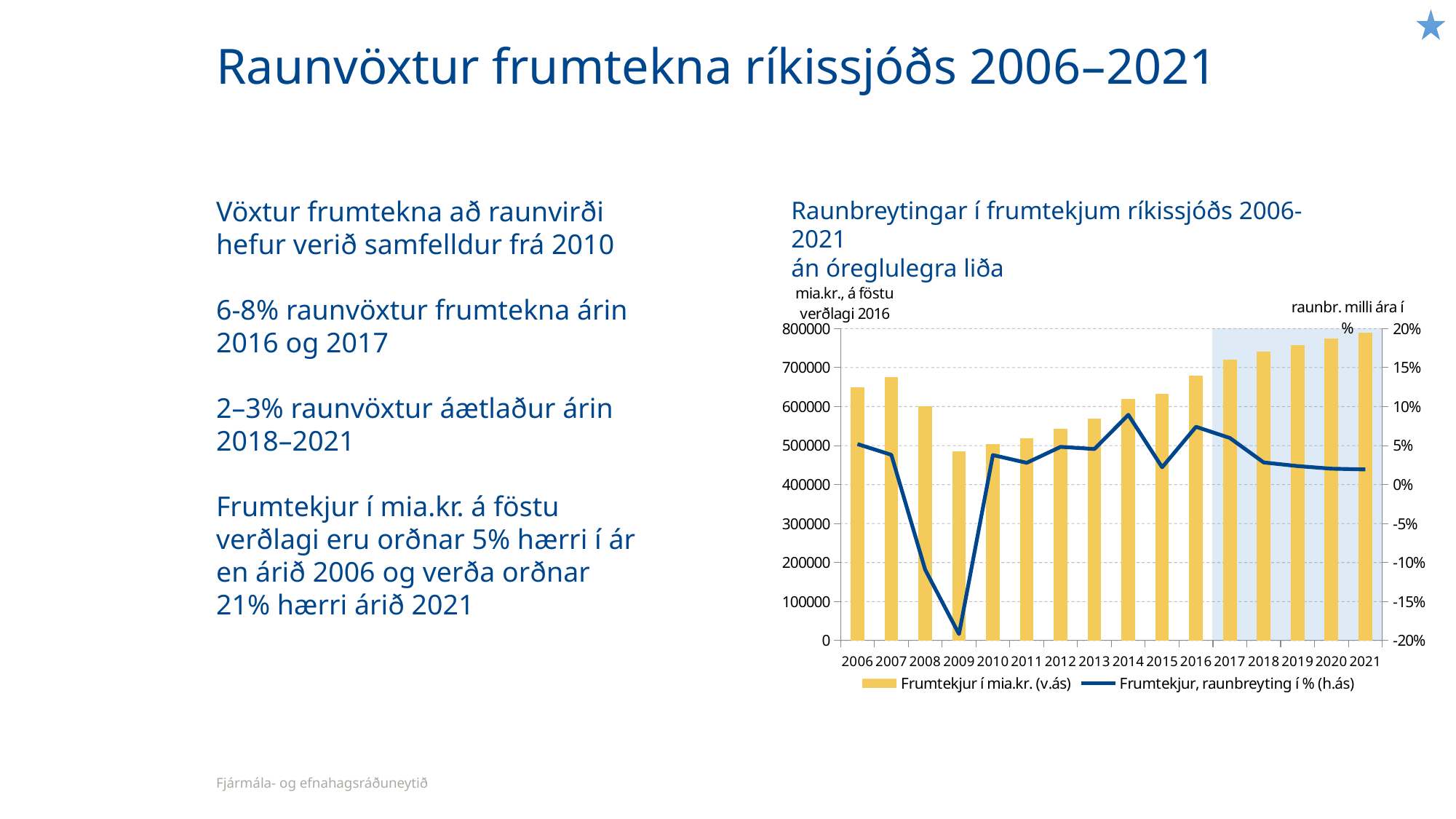
In which year does the line Frumtekjur, raunbreyting í % reach its highest point? 2014 How many series does the chart legend list? 2 How many years are shown on the x axis of the chart? 16 In which year does the line Frumtekjur, raunbreyting í % reach its lowest point? 2009 Is the bar value for 2017 greater or less than 700000? greater Is the line value for 2009 greater or less than -15%? less Do the bars rise or fall from 2009 to 2021? Rise Which year has the lowest bar for Frumtekjur í mia.kr.? 2009 Which series is plotted on the right-hand axis (h.ás) according to the legend? Frumtekjur, raunbreyting í % (h.ás) What kind of chart is shown on the slide? Combined bar and line chart Which year has the taller bar, 2007 or 2008? 2007 Which year has the highest bar for Frumtekjur í mia.kr.? 2021